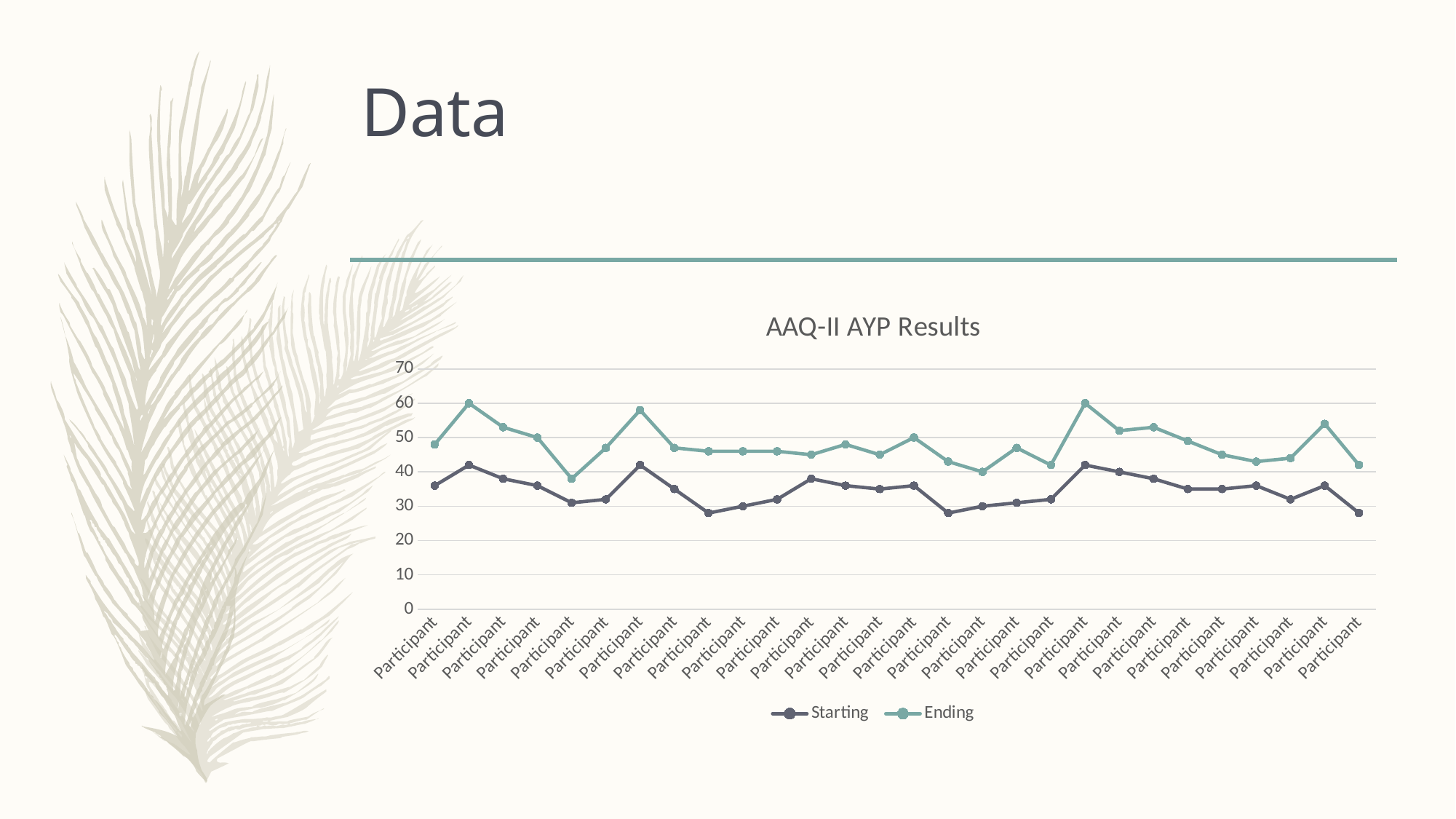
What is the Ending value for the second participant from the left? 60 What kind of chart is shown on the slide? line chart What is the title of the chart? AAQ-II AYP Results Is the highest Starting value greater or less than 50? less What are the two series named in the legend? Starting and Ending What is the highest value reached by the Ending series? 60 How many series does the legend list? 2 Is the Starting value for the first participant greater or less than 40? less How many participants (data points per series) are plotted on the x axis? 28 Is the Ending value for the fifth participant from the left greater or less than 50? less For the last participant on the right, which series has the larger value, Starting or Ending? Ending For the first participant on the left, which series has the larger value, Starting or Ending? Ending